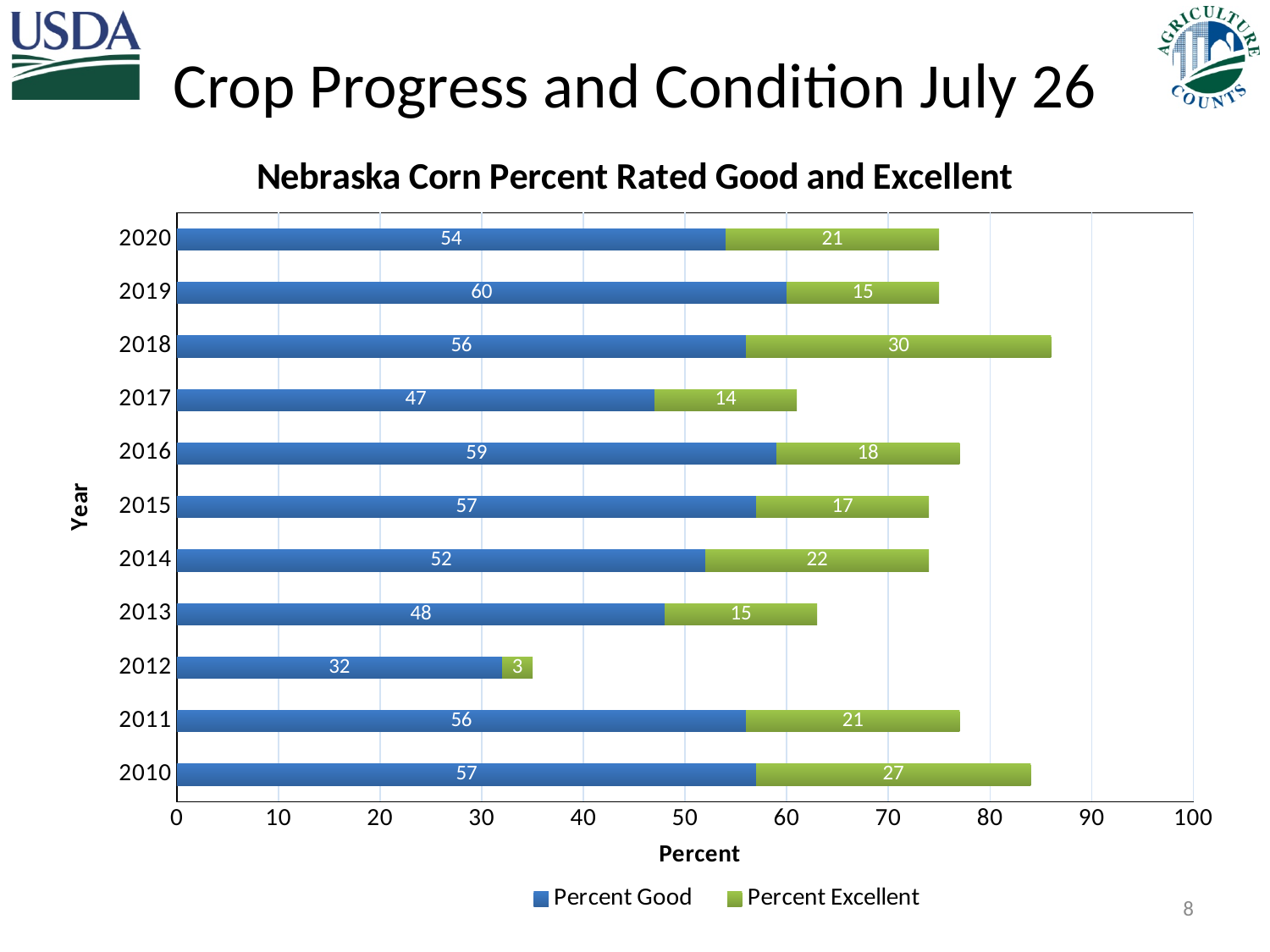
Which year has the lowest Percent Good value? 2012 What is the difference between the Percent Good values for 2019 and 2012? 28 Which is larger, the Percent Excellent value for 2014 or for 2017? 2014 What is the title of the chart? Nebraska Corn Percent Rated Good and Excellent How many years are shown on the chart? 11 What is the total of the stacked bar for 2010 (Percent Good plus Percent Excellent)? 84 How many series does the legend list? 2 What is the Percent Good value for 2020? 54 Which year has the highest Percent Excellent value? 2018 What is the label of the horizontal axis? Percent What is the Percent Excellent value for 2018? 30 What kind of chart is shown on the slide? Stacked bar chart